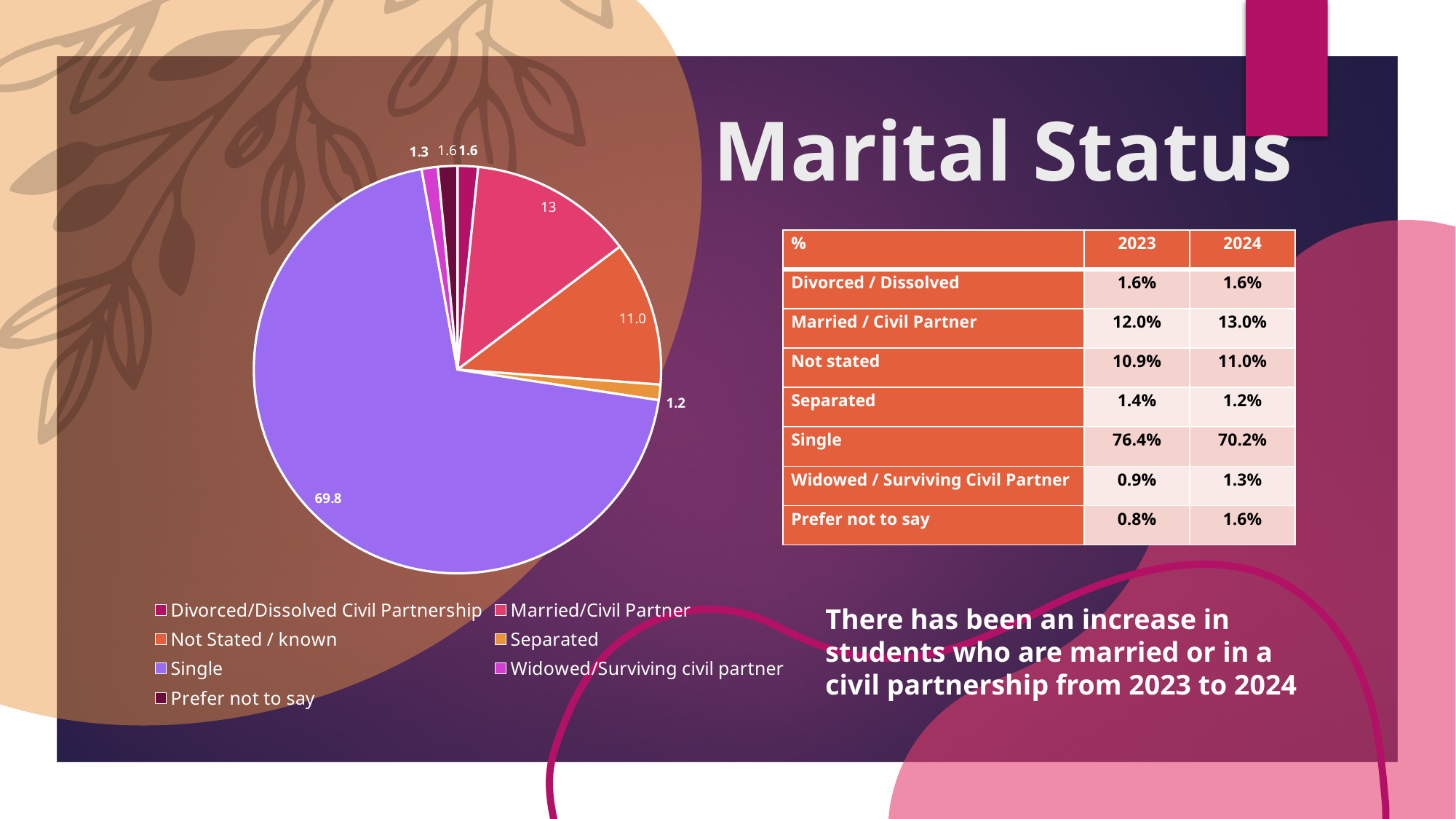
What type of chart is shown on the slide? Pie chart How many categories does the pie chart's legend list? 7 Which category has the largest slice in the pie chart? Single What is the value shown for the Widowed/Surviving civil partner slice in the pie chart? 1.3 What is the value shown for the Separated slice in the pie chart? 1.2 Which is larger in the pie chart, Married/Civil Partner or Not Stated / known? Married/Civil Partner What is the value shown for the Single slice in the pie chart? 69.8 What colour is the Single slice in the pie chart? Purple What is the difference between the Single value and the Married/Civil Partner value in the pie chart? 56.8 What is the value shown for the Not Stated / known slice in the pie chart? 11.0 Which category has the smallest slice in the pie chart? Separated What is the value shown for the Married/Civil Partner slice in the pie chart? 13